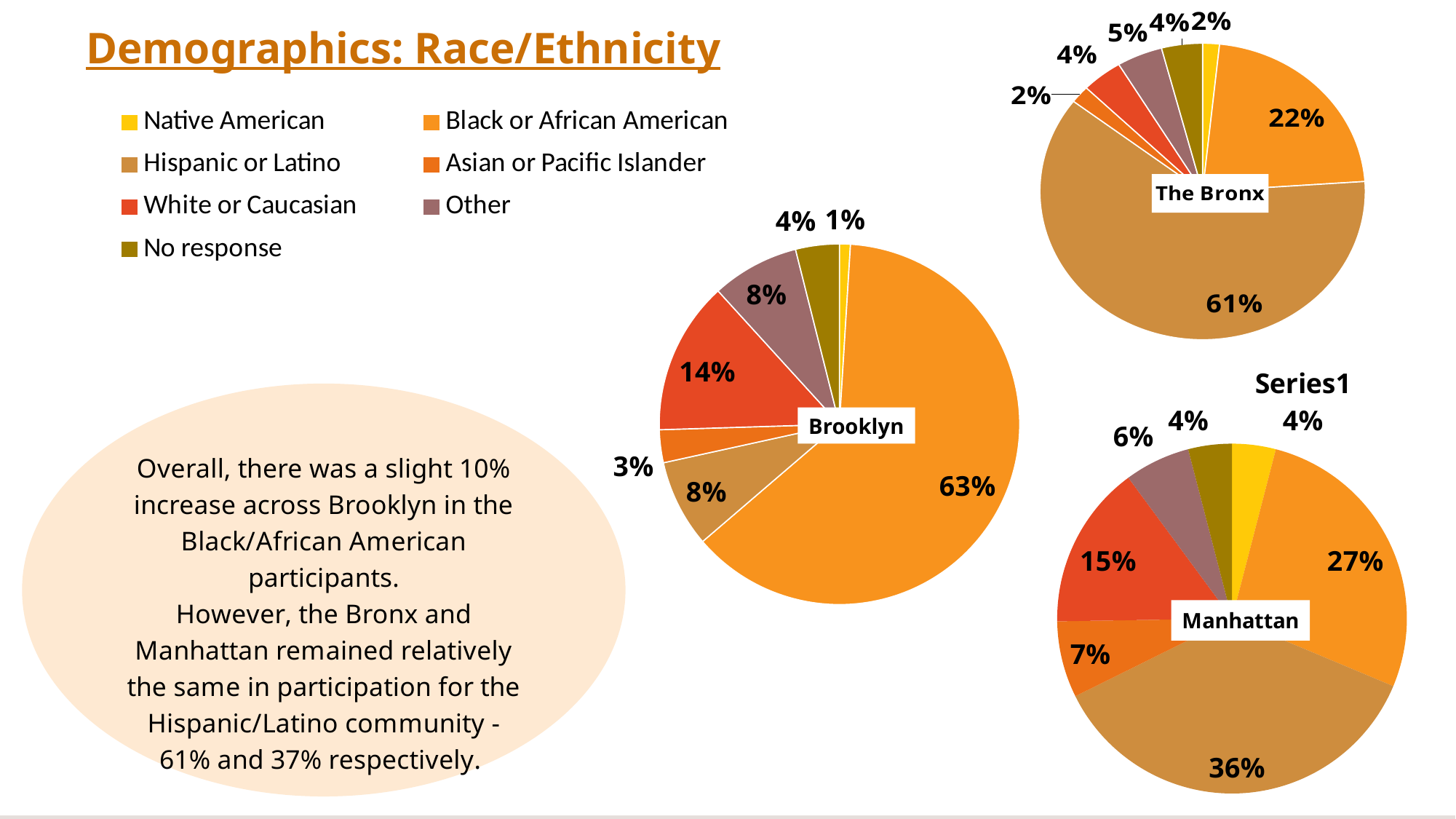
In the Brooklyn pie chart, which category has the smallest slice? Native American In the Manhattan pie chart, which category has the largest slice? Hispanic or Latino In the Brooklyn pie chart, what share is White or Caucasian? 14% In The Bronx pie chart, what share is Hispanic or Latino? 61% How many pie charts are on the slide? 3 In the Manhattan pie chart, what share is Asian or Pacific Islander? 7% How many race/ethnicity categories does the legend list? 7 In the Manhattan pie chart, what share is Hispanic or Latino? 36% What kind of charts are shown on the slide? Pie charts What is the difference between the Black or African American share in Brooklyn and in The Bronx? 41 percentage points Which is larger: the White or Caucasian share in Manhattan or in Brooklyn? Manhattan In the Brooklyn pie chart, what share is Black or African American? 63%